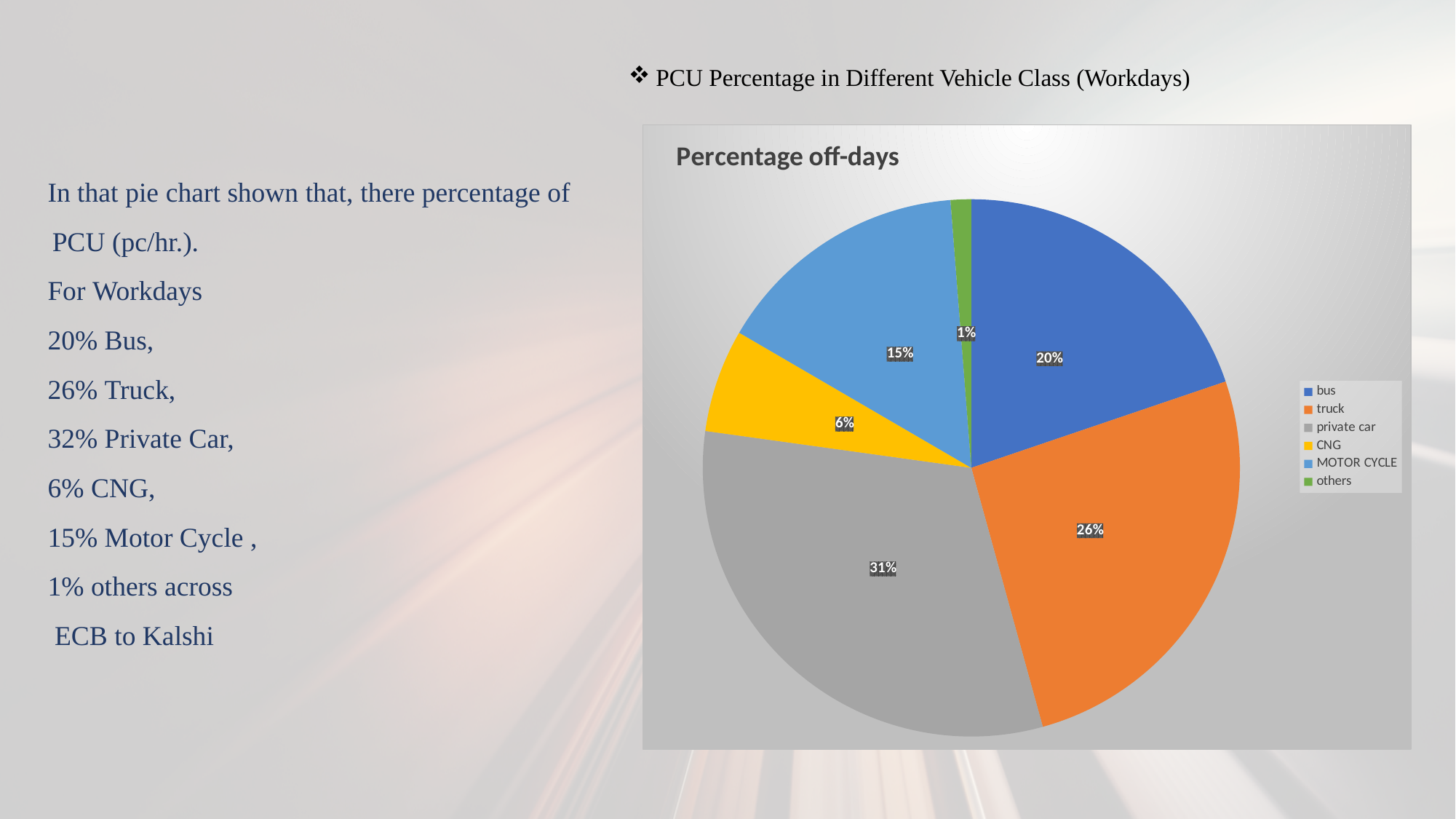
Which slice is larger, MOTOR CYCLE or CNG? MOTOR CYCLE What is the difference in percentage points between the truck slice and the bus slice? 6 What percentage does the bus slice show? 20% What percentage does the private car slice show? 31% What percentage does the truck slice show? 26% How many categories does the legend list? 6 What is the title of the chart? Percentage off-days What type of chart is shown on the slide? pie chart Which category has the smallest slice of the pie? others What percentage does the CNG slice show? 6% Which category has the largest slice of the pie? private car What percentage does the MOTOR CYCLE slice show? 15%